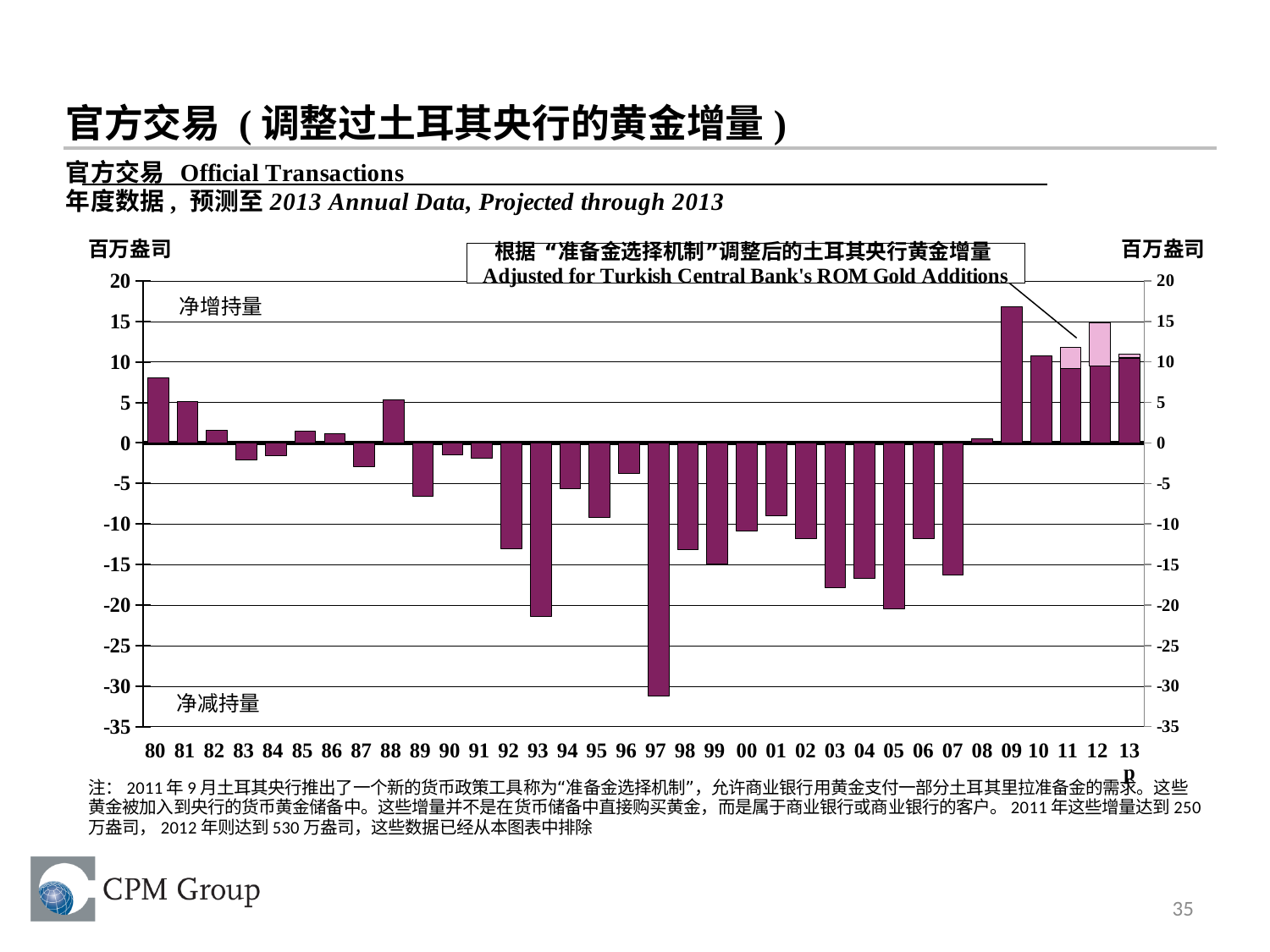
What kind of chart is shown on the slide? bar chart Which is larger, the value for 80 or the value for 81? 80 Does the value rise or fall from 08 to 09? rise Is the value for 05 greater or less than -15? less Is the value for 80 greater or less than 5? greater Is the value for 97 greater or less than -25? less What unit is shown on the y axis of the chart? 百万盎司 Which year has the highest value in the chart? 09 How many years are plotted along the x axis of the chart? 34 Which is larger, the value for 09 or the value for 10? 09 Which year has the lowest value in the chart? 97